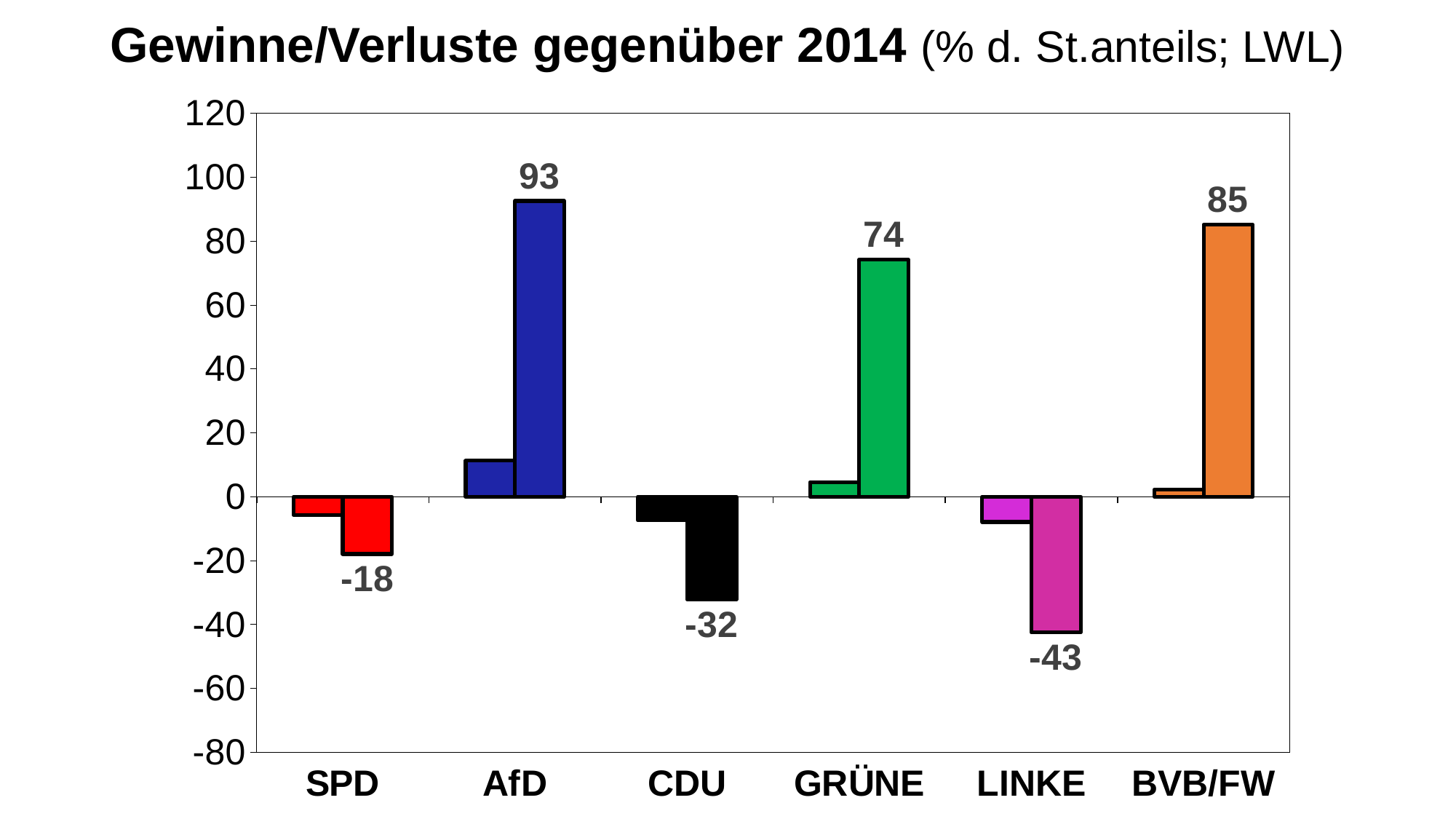
What is the labelled value for GRÜNE? 74 Which party has the lowest labelled value? LINKE What kind of chart is shown on the slide? bar chart What is the title of the chart? Gewinne/Verluste gegenüber 2014 (% d. St.anteils; LWL) What is the labelled value for AfD? 93 What is the difference between the labelled values for AfD and BVB/FW? 8 Which has a larger labelled value, GRÜNE or BVB/FW? BVB/FW What is the labelled value for LINKE? -43 How many parties are shown on the x axis? 6 What is the labelled value for CDU? -32 Which party has the highest labelled value? AfD Is the value of the unlabelled (left) bar for AfD greater or less than 20? less